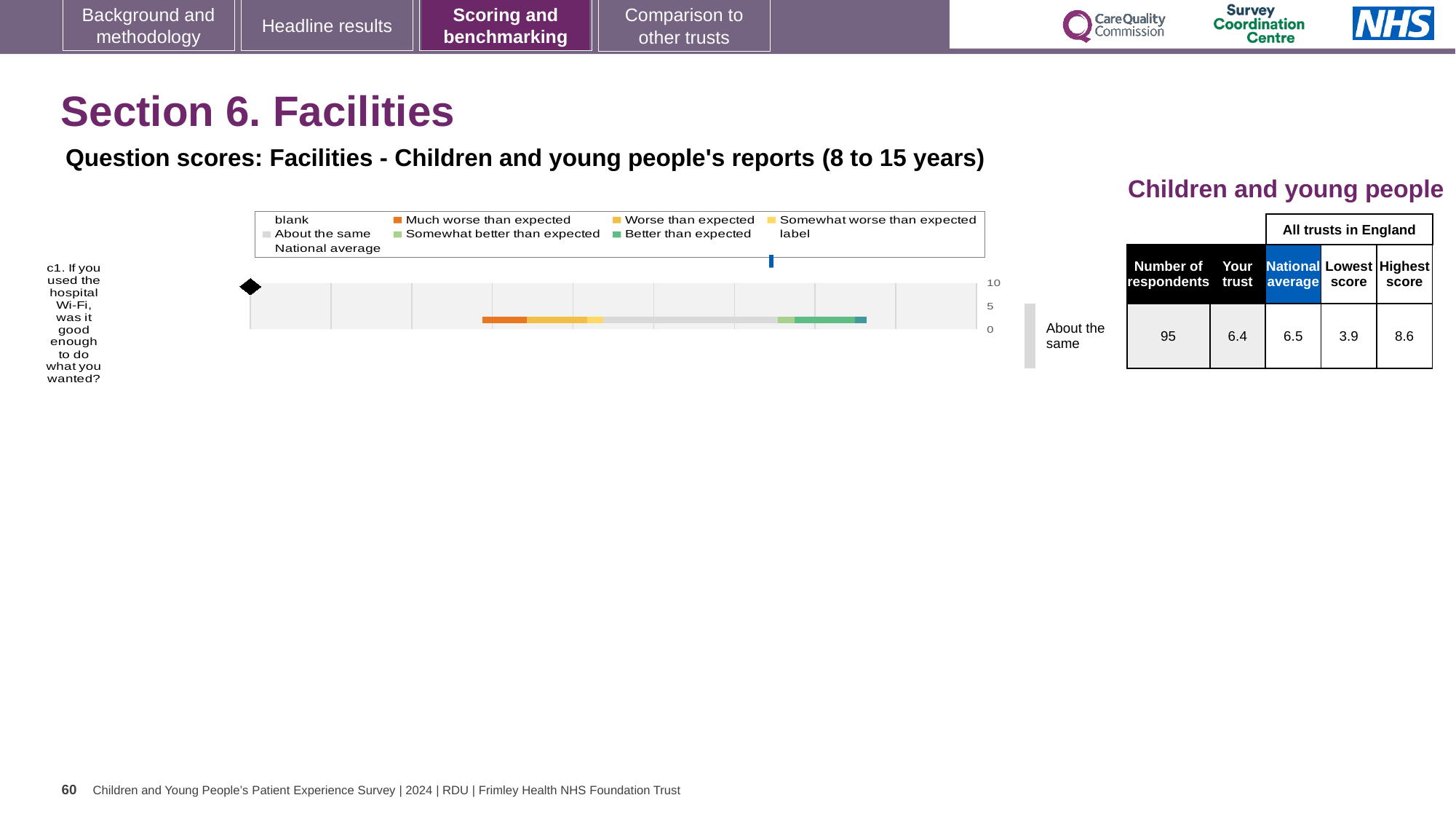
What is the difference between the highest and lowest scores for question c1? 4.7 What is the highest score among all trusts in England for question c1? 8.6 What is the 'Your trust' score for question c1? 6.4 What kind of chart is shown on the slide? bar chart Which question is plotted in the chart? c1. If you used the hospital Wi-Fi, was it good enough to do what you wanted? What is the lowest score among all trusts in England for question c1? 3.9 How many respondents answered question c1? 95 How many survey questions are plotted in the chart? 1 What is the national average score for question c1? 6.5 What rating category is given for question c1? About the same Which is larger for question c1, the 'Your trust' score or the national average? National average What colour does the legend use for 'Much worse than expected'? orange